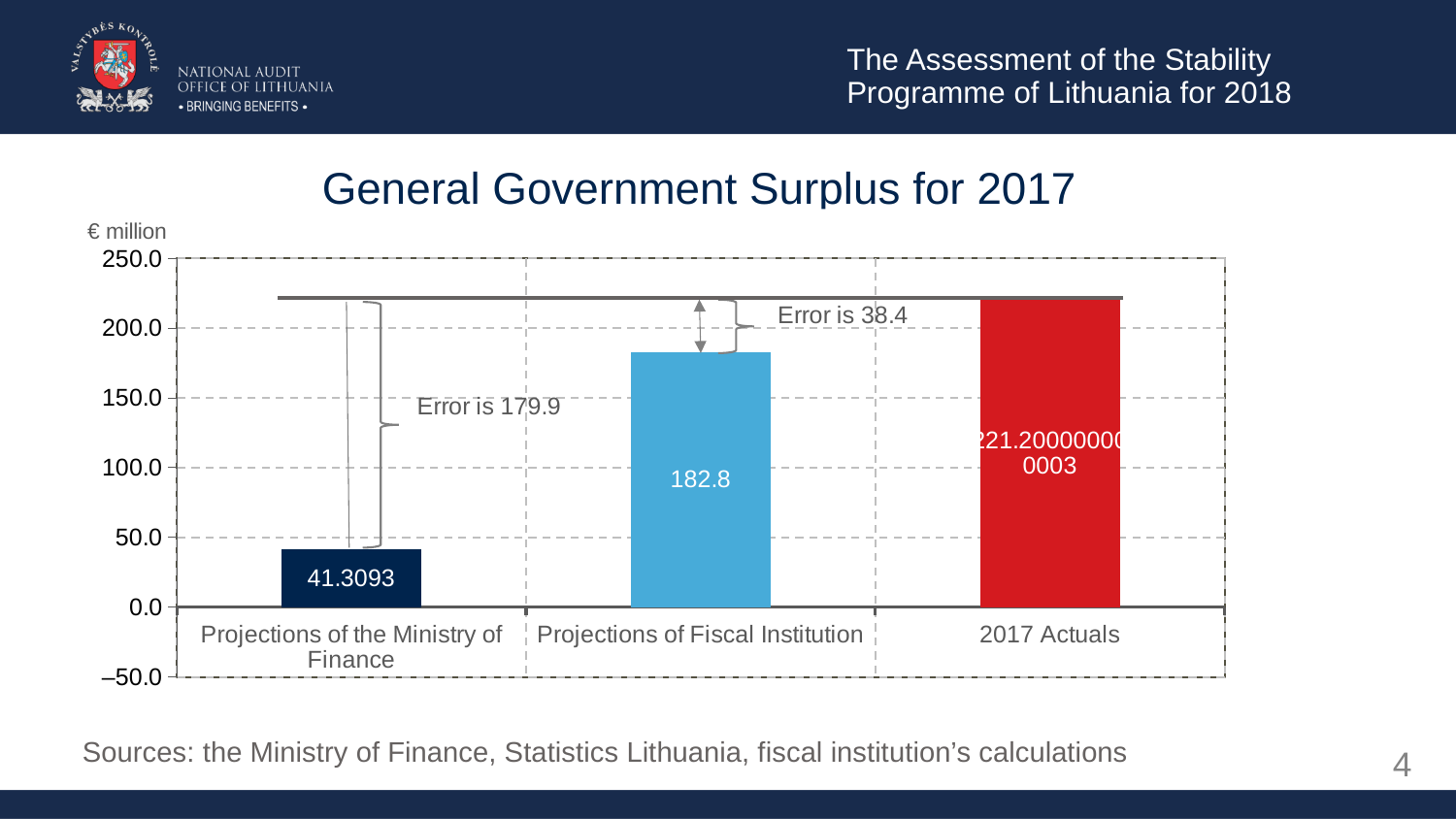
Is the value for 2017 Actuals greater or less than 200.0? greater What is the difference between the value for Projections of Fiscal Institution and the value for Projections of the Ministry of Finance? 141.4907 What is the title of the chart? General Government Surplus for 2017 What is the value for Projections of the Ministry of Finance? 41.3093 What unit is shown on the vertical axis of the chart? € million What is the value for Projections of Fiscal Institution? 182.8 Which category has the highest value? 2017 Actuals What type of chart is shown on the slide? bar chart Is the value for Projections of the Ministry of Finance greater or less than 50.0? less Which category has the lowest value? Projections of the Ministry of Finance How many bars (categories) are plotted in the chart? 3 Which is larger: the value for Projections of Fiscal Institution or the value for Projections of the Ministry of Finance? Projections of Fiscal Institution